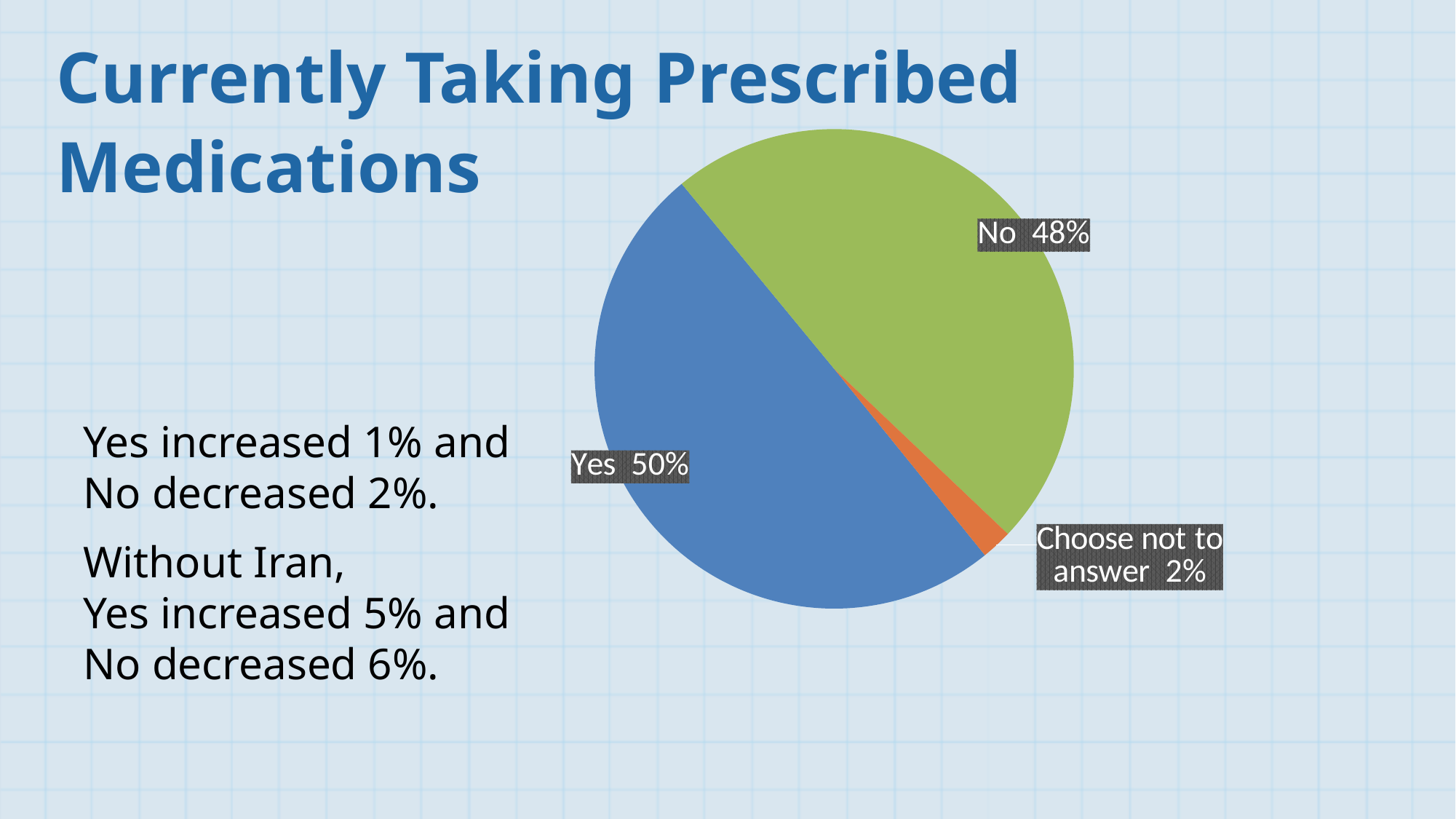
Which category has the largest share of the pie? Yes What is the difference in percentage points between the No slice and the Choose not to answer slice? 46 What percentage of respondents chose not to answer? 2% How many slices does the pie chart have? 3 What colour is the Yes slice of the pie chart? Blue Which category has the smallest share of the pie? Choose not to answer What kind of chart is shown on the slide? Pie chart Which is larger, the No slice or the Choose not to answer slice? No What is the difference in percentage points between the Yes and No slices? 2 What percentage of respondents answered Yes to currently taking prescribed medications? 50% What is the title of the slide containing the chart? Currently Taking Prescribed Medications What percentage of respondents answered No? 48%